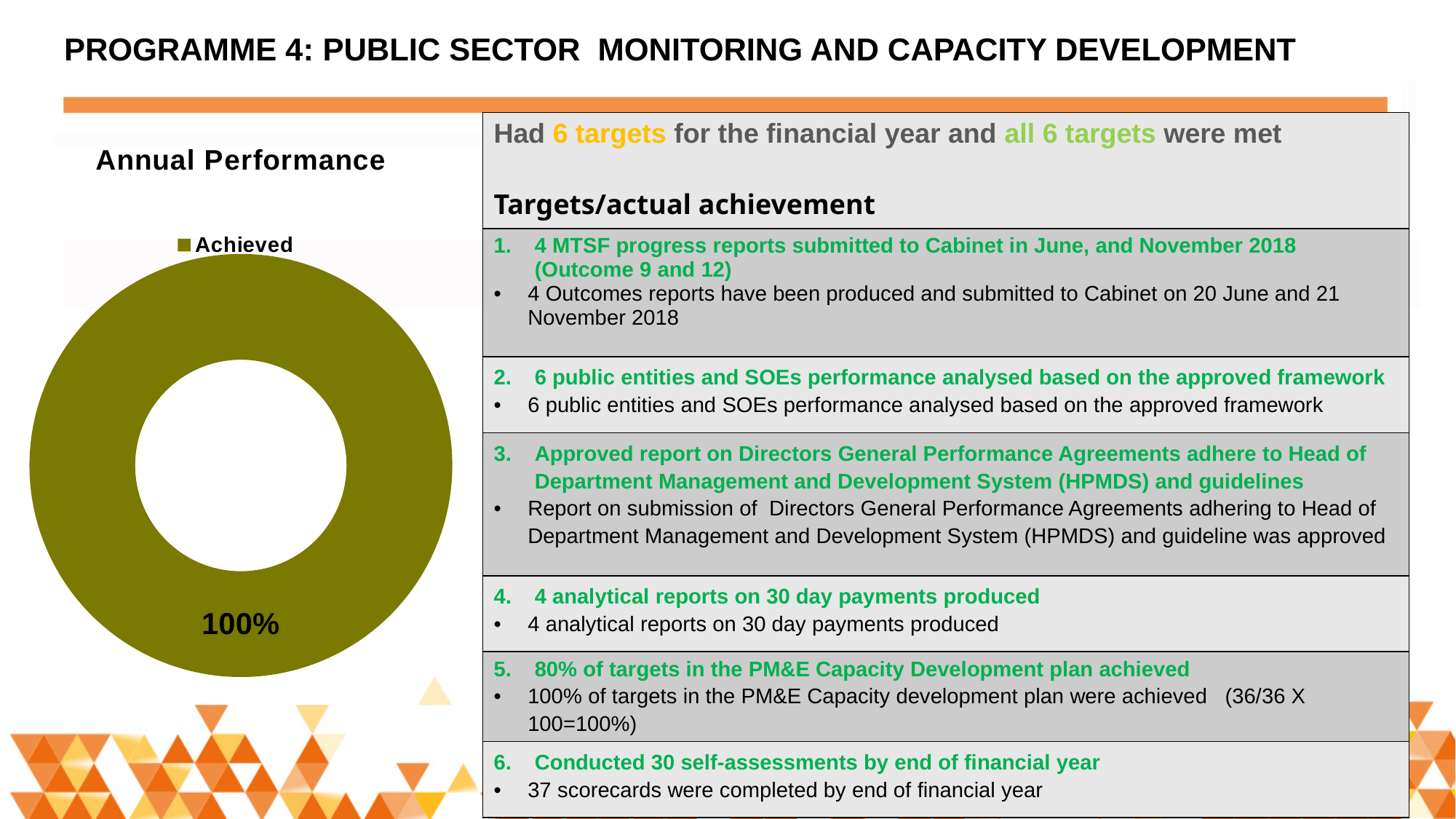
How many entries does the legend of the Annual Performance chart list? 1 What is the only legend entry shown for the Annual Performance chart? Achieved How many slices are shown in the Annual Performance chart? 1 What kind of chart is shown under the heading 'Annual Performance'? Doughnut chart What share of the Annual Performance doughnut does the 'Achieved' slice take up? 100% What is the title shown above the doughnut chart? Annual Performance What value is labelled on the 'Achieved' slice of the Annual Performance chart? 100%